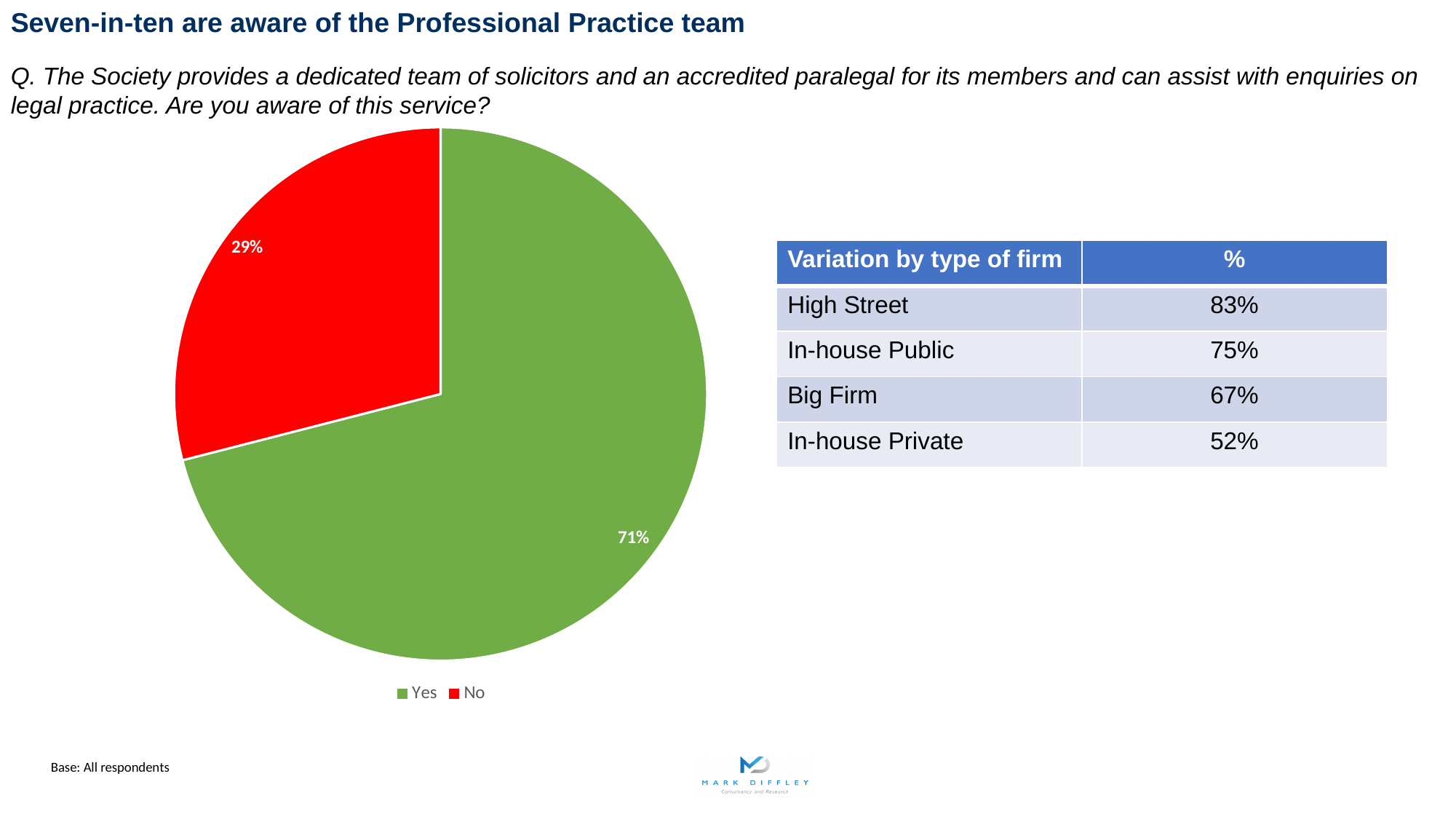
How many entries does the pie chart legend list? 2 What is the difference in percentage points between the Yes and No slices of the pie chart? 42 Which slice of the pie chart is the smallest? No Which is larger in the pie chart, the Yes slice or the No slice? Yes What colour is the Yes slice in the pie chart? green What colour is the No slice in the pie chart? red What kind of chart is shown on the slide? pie chart What percentage of respondents answered No in the pie chart? 29% What percentage of respondents answered Yes in the pie chart? 71% Which slice of the pie chart is the largest? Yes How many slices does the pie chart have? 2 What share of the pie chart does the No slice represent? 29%